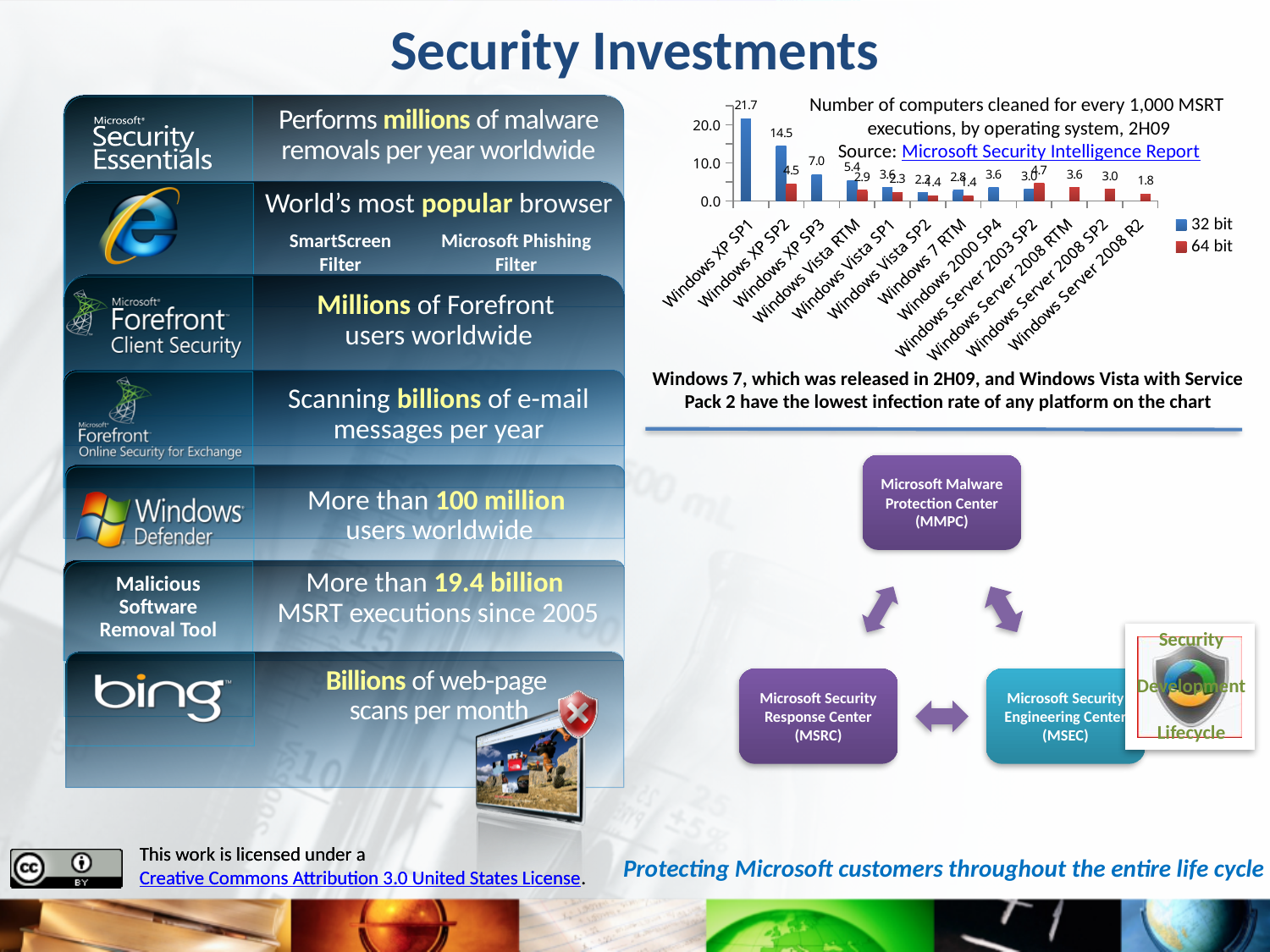
What is the 32 bit value for Windows XP SP1? 21.7 What is the 64 bit value for Windows XP SP2? 4.5 How many operating systems are shown along the x axis of the chart? 12 For Windows XP SP2, which is larger, the 32 bit value or the 64 bit value? 32 bit Which operating system has the highest 32 bit value in the chart? Windows XP SP1 How many series does the chart legend list? 2 What is the 32 bit value for Windows XP SP3? 7.0 Is the 32 bit value for Windows XP SP1 greater or less than 20.0? greater What kind of chart is shown on the slide? bar chart What are the two series named in the chart legend? 32 bit and 64 bit What is the difference between the 32 bit values for Windows XP SP1 and Windows XP SP2? 7.2 What is the 32 bit value for Windows XP SP2? 14.5